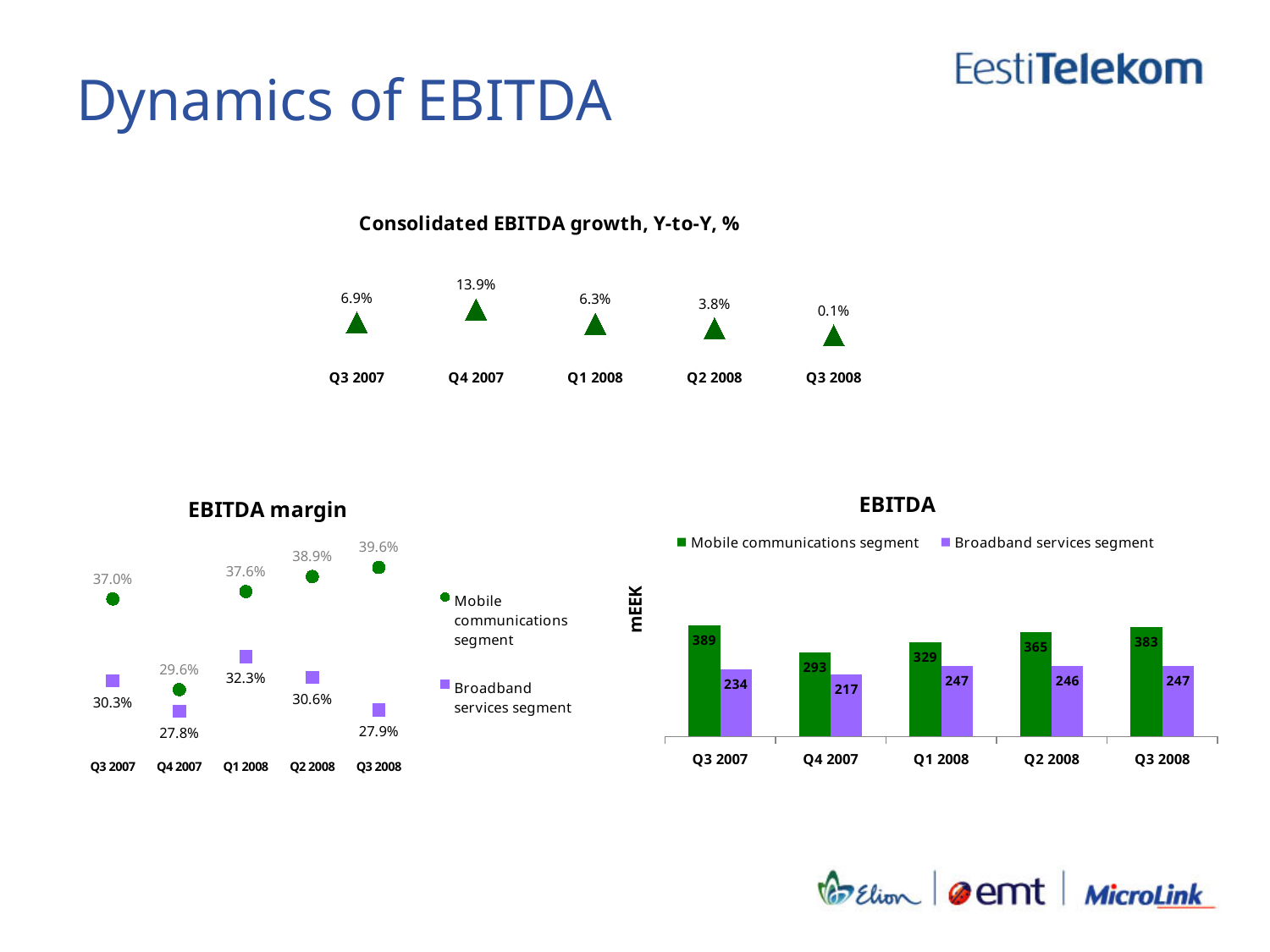
In the 'EBITDA' chart, what is the value for the Mobile communications segment in Q3 2007? 389 In the 'EBITDA margin' chart, what is the value for the Mobile communications segment in Q3 2008? 39.6% In the 'EBITDA margin' chart, how many series does the legend list? 2 In the 'EBITDA margin' chart, what is the difference between the Mobile communications segment and the Broadband services segment in Q3 2007? 6.7% In the 'EBITDA' chart, which quarter has the lowest value for the Broadband services segment? Q4 2007 In the 'Consolidated EBITDA growth, Y-to-Y, %' chart, what is the value for Q4 2007? 13.9% In the 'Consolidated EBITDA growth, Y-to-Y, %' chart, which quarter has the lowest value? Q3 2008 In the 'Consolidated EBITDA growth, Y-to-Y, %' chart, how many quarters are plotted? 5 What kind of chart is the 'EBITDA' chart? bar chart In the 'Consolidated EBITDA growth, Y-to-Y, %' chart, do the values rise or fall from Q4 2007 to Q3 2008? fall In the 'EBITDA margin' chart, what is the value for the Broadband services segment in Q1 2008? 32.3% In the 'EBITDA' chart, what is the difference between the Mobile communications segment and the Broadband services segment in Q3 2008? 136